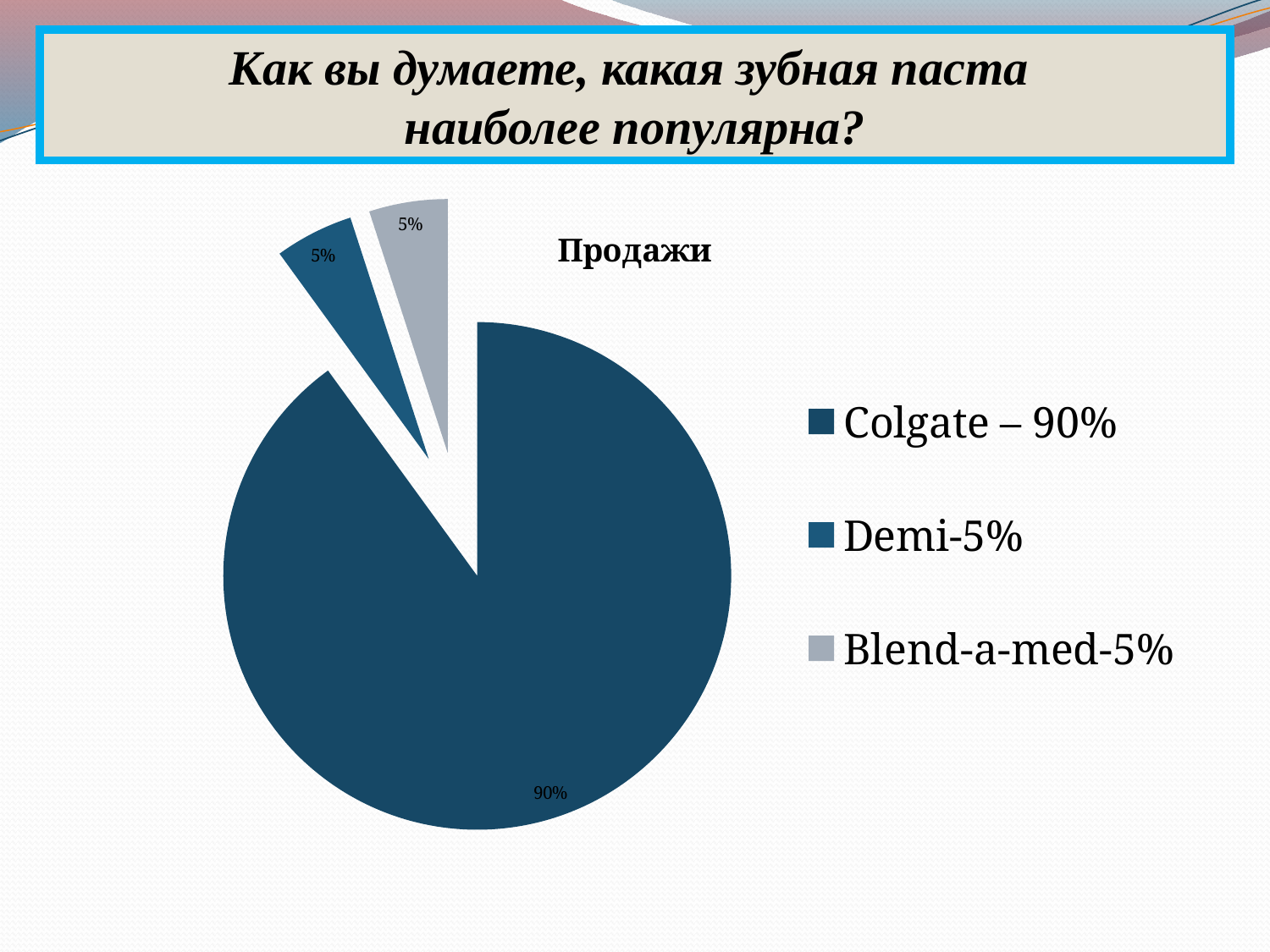
Is the value for Colgate greater or less than 50%? greater Which legend entry is shown in light grey? Blend-a-med-5% What share of the pie does Blend-a-med have? 5% Which category has the largest slice of the pie? Colgate How many entries does the legend list? 3 Which is larger, the Colgate slice or the Blend-a-med slice? Colgate What share of the pie does Colgate have? 90% What is the difference between the Colgate share and the Demi share? 85% What share of the pie does Demi have? 5% What kind of chart is shown on the slide? pie chart How many slices does the pie chart have? 3 What is the title of the chart? Продажи